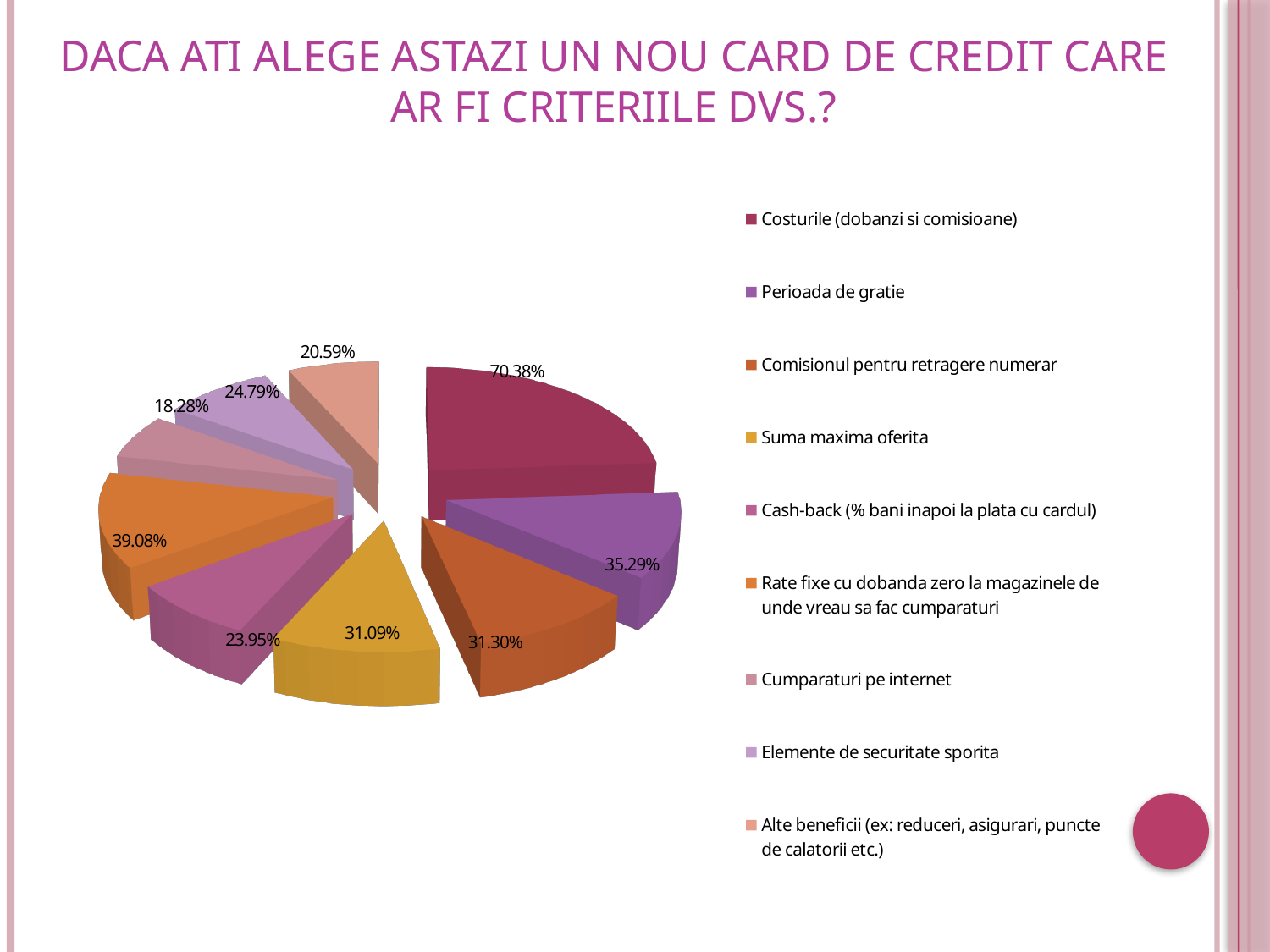
Which category has the highest value? Costurile (dobanzi si comisioane) How many slices does the pie chart have? 9 Which is larger, the value for Rate fixe cu dobanda zero la magazinele de unde vreau sa fac cumparaturi or the value for Cash-back (% bani inapoi la plata cu cardul)? Rate fixe cu dobanda zero la magazinele de unde vreau sa fac cumparaturi Which category has the lowest value? Cumparaturi pe internet What is the value for Costurile (dobanzi si comisioane)? 70.38% What is the value for Alte beneficii (ex: reduceri, asigurari, puncte de calatorii etc.)? 20.59% What kind of chart is shown on the slide? Pie chart What is the value for Rate fixe cu dobanda zero la magazinele de unde vreau sa fac cumparaturi? 39.08% What is the value for Perioada de gratie? 35.29% What is the difference between the values for Costurile (dobanzi si comisioane) and Perioada de gratie? 35.09% How many entries does the legend list? 9 What is the value for Cumparaturi pe internet? 18.28%